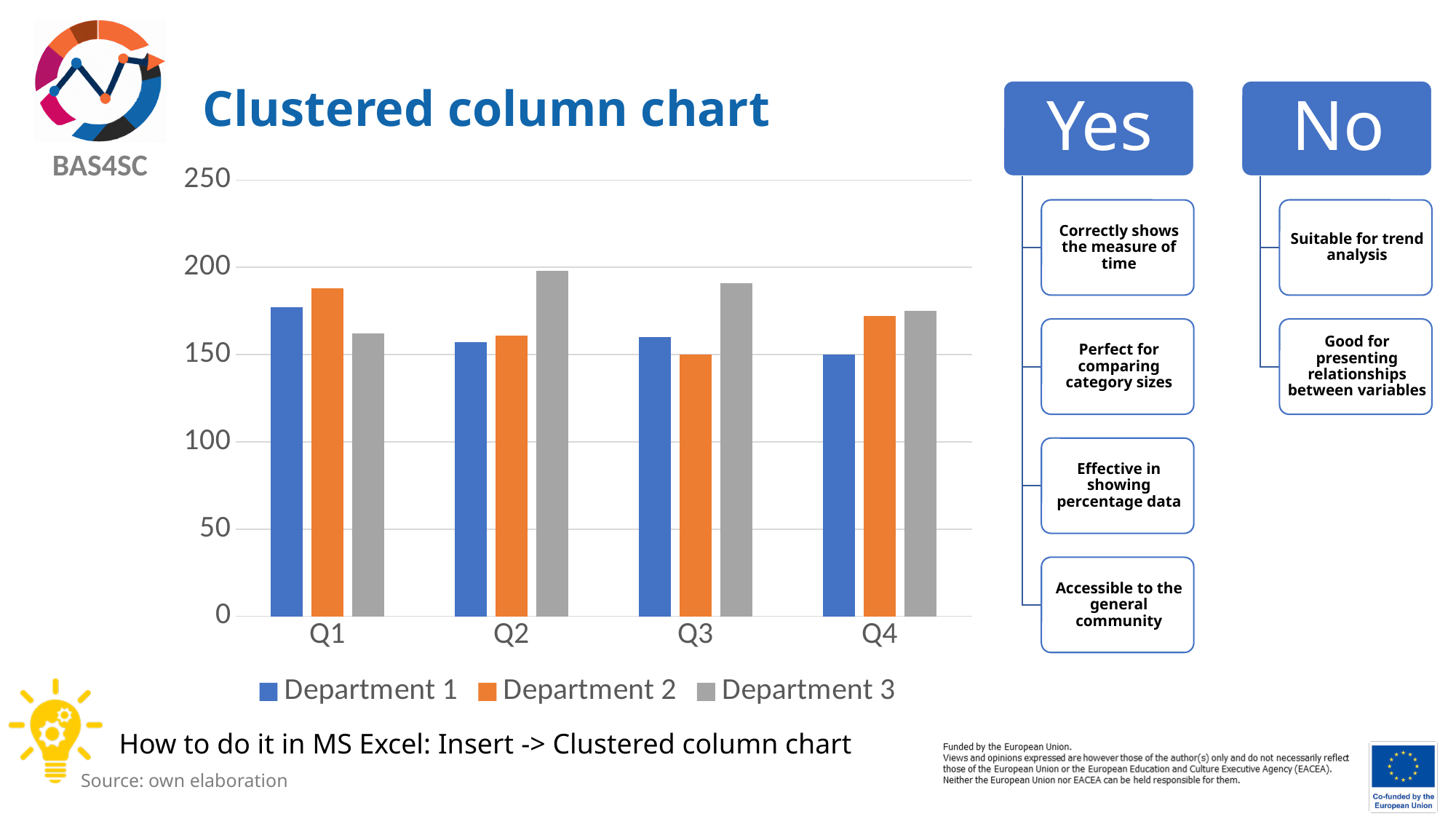
Which department has the tallest bar in Q2? Department 3 What kind of chart is shown on the slide? bar chart Is the value for Department 3 in Q4 greater or less than 200? less In Q1, which is larger: Department 2 or Department 3? Department 2 Is the value for Department 1 in Q1 greater or less than 200? less How many quarters are shown on the x axis of the chart? 4 How many series does the chart legend list? 3 Is the value for Department 3 in Q2 greater or less than 150? greater Which colour represents Department 2 in the chart legend? orange What is the title of the slide containing the chart? Clustered column chart Which department has the lowest bar in Q3? Department 2 In Q4, which is larger: Department 1 or Department 2? Department 2